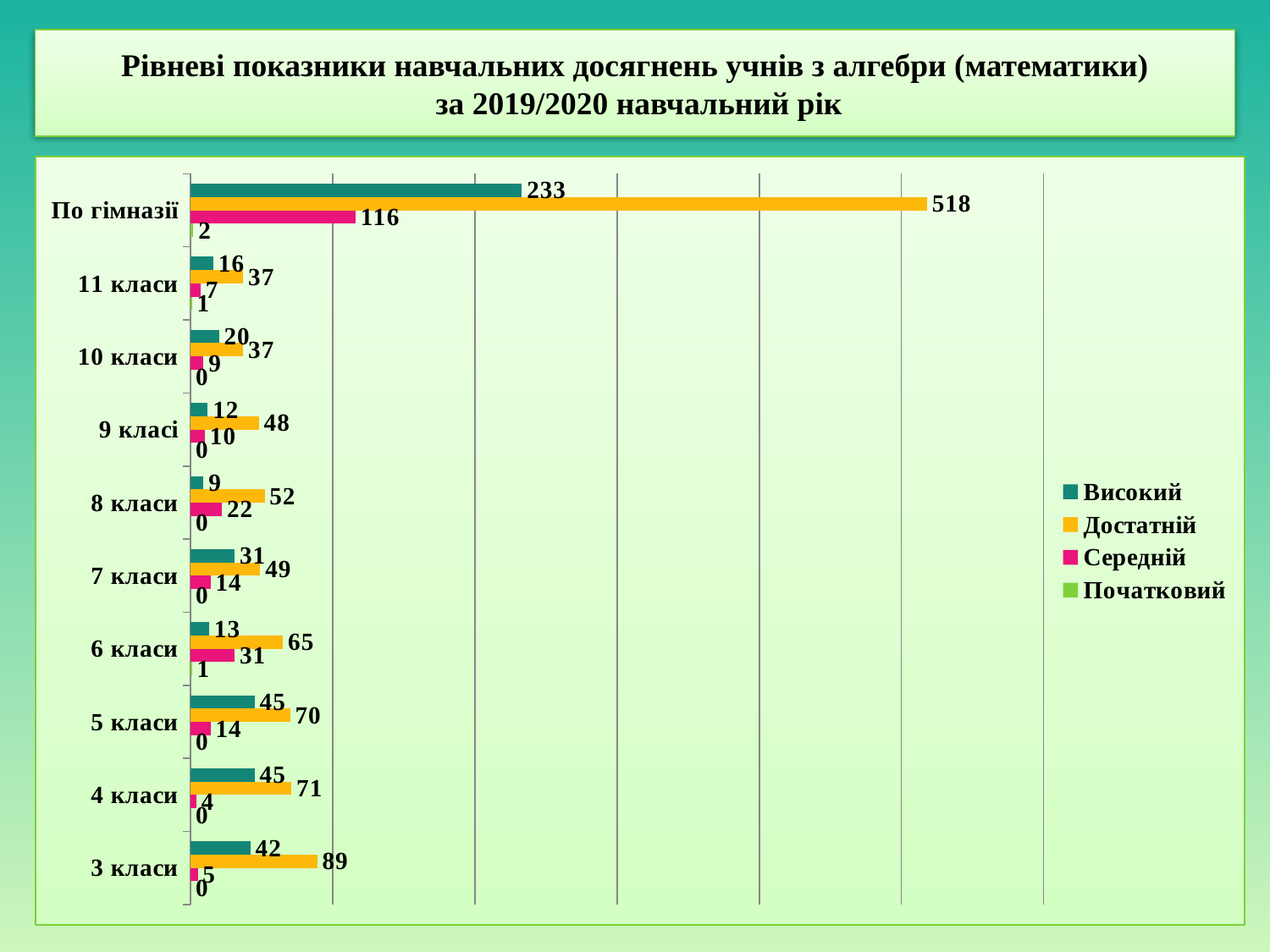
Which is larger: the Середній value for 6 класи or the Середній value for 5 класи? 6 класи Which legend entry is shown in orange? Достатній What is the value of Середній for 8 класи? 22 How many categories are shown on the vertical axis? 10 Among the class categories (excluding По гімназії), which has the highest Достатній value? 3 класи What is the value of Високий for 3 класи? 42 Among the class categories (excluding По гімназії), which has the lowest Високий value? 8 класи How many series does the legend list? 4 What is the value of Достатній for По гімназії? 518 What is the difference between the Достатній and Високий values for По гімназії? 285 What is the value of Початковий for 6 класи? 1 What kind of chart is shown on the slide? Bar chart